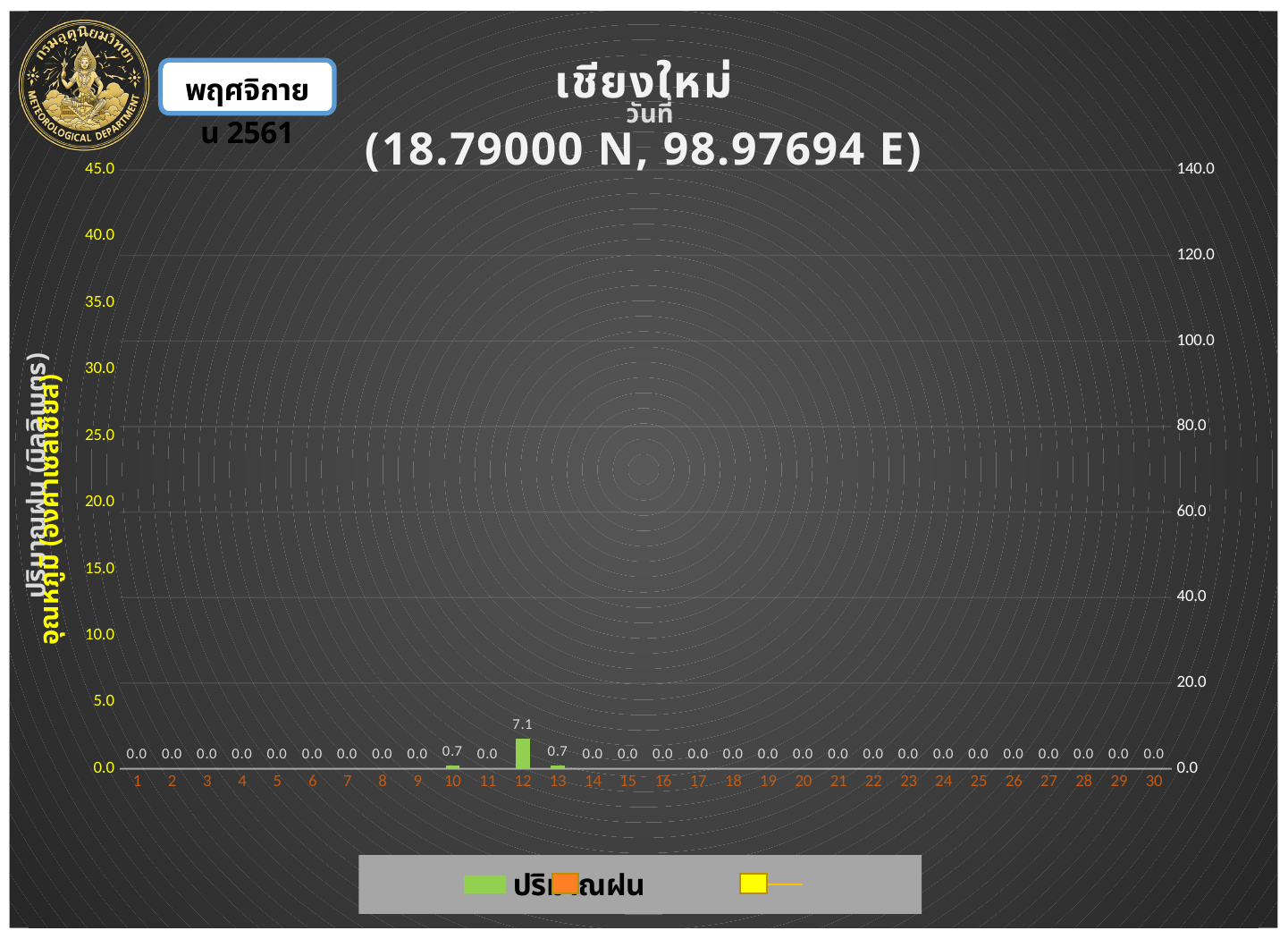
How many days are shown on the x axis? 30 What is the difference between the rainfall values for day 12 and day 10? 6.4 Is the rainfall value for day 12 greater or less than 10.0 on the left axis? less What is the rainfall value shown for day 12? 7.1 What is the rainfall value shown for day 13? 0.7 What is the rainfall value shown for day 10? 0.7 Which day has the highest rainfall value? 12 What is the rainfall value shown for day 1? 0.0 What is the highest value shown on the right vertical axis? 140.0 What is the highest value shown on the left vertical axis? 45.0 Which has a larger rainfall value, day 12 or day 13? day 12 What kind of chart is used to show the rainfall values? bar chart